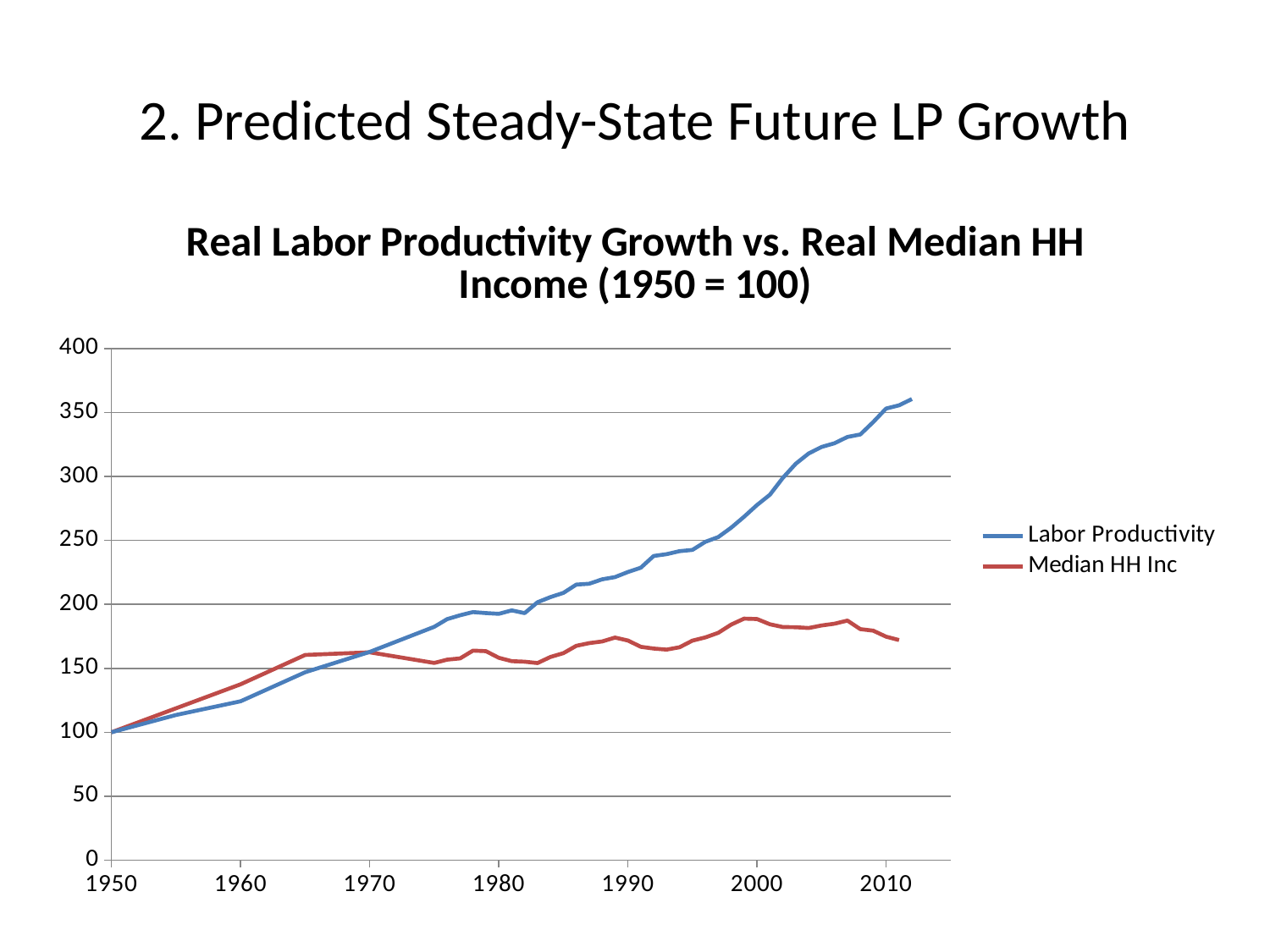
How many series does the legend list? 2 Is the value for Labor Productivity in 2000 greater or less than 250? greater Is the value for Labor Productivity in 2010 greater or less than 300? greater In 2010, which series has the higher value, Labor Productivity or Median HH Inc? Labor Productivity Does the Labor Productivity line generally rise or fall from 1950 to 2010? rise What is the title of the chart? Real Labor Productivity Growth vs. Real Median HH Income (1950 = 100) What is the value of Labor Productivity in 1950? 100 Is the value for Median HH Inc in 2010 greater or less than 200? less What kind of chart is shown on the slide? line chart What is the value of Median HH Inc in 1950? 100 In 1960, which series has the higher value, Labor Productivity or Median HH Inc? Median HH Inc